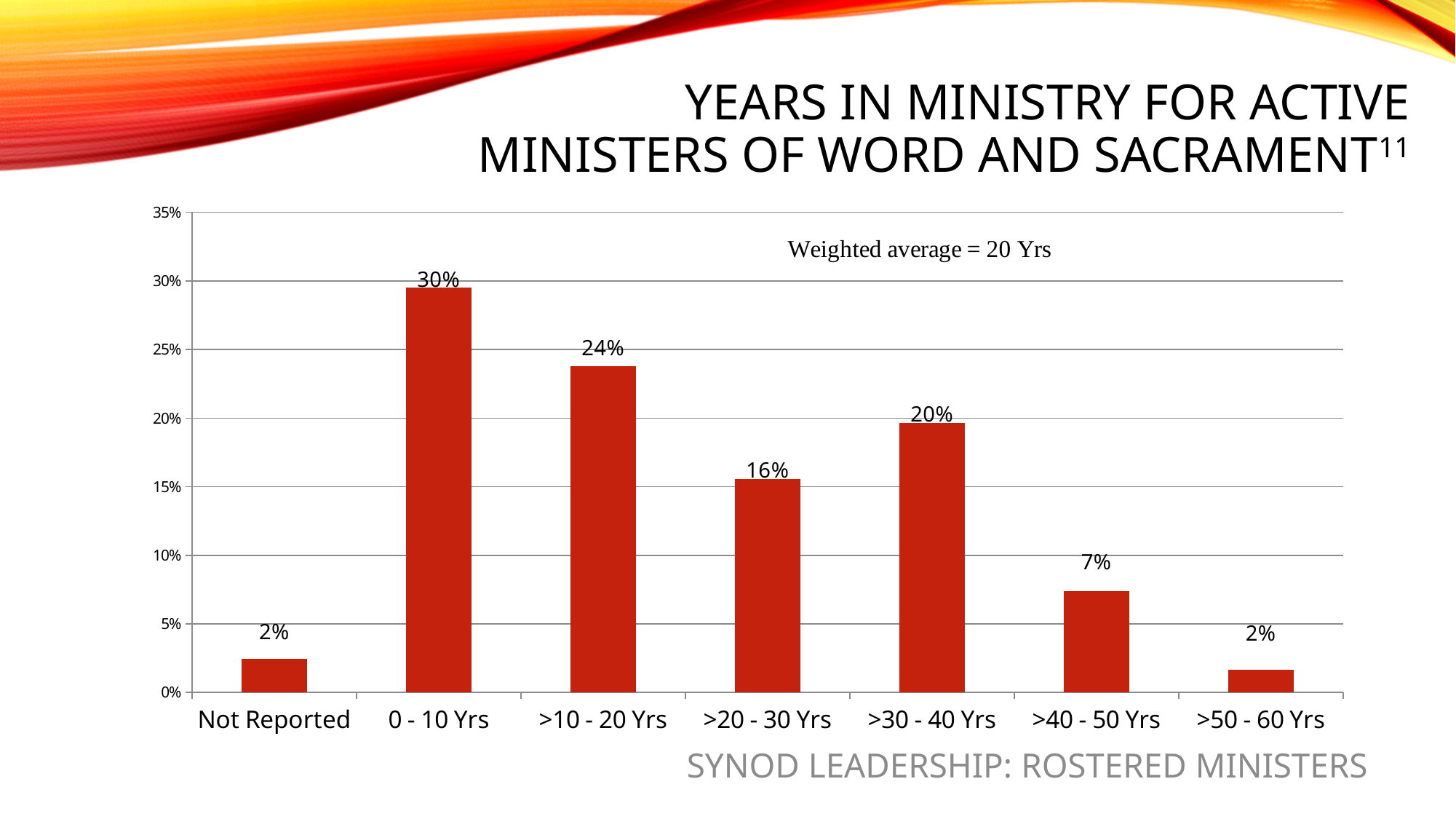
From 0 - 10 Yrs to >50 - 60 Yrs, do the values generally rise or fall? Fall How many categories are shown on the x axis? 7 What is the value for the >30 - 40 Yrs category? 20% What percentage of active ministers have 0 - 10 years in ministry? 30% Which is larger, the value for >20 - 30 Yrs or the value for >30 - 40 Yrs? >30 - 40 Yrs What weighted average is stated on the chart? 20 Yrs What is the difference between the >10 - 20 Yrs and >20 - 30 Yrs values? 8% What is the value for the Not Reported category? 2% Which category has the highest value? 0 - 10 Yrs What kind of chart is shown on the slide? Bar chart What percentage is shown for >40 - 50 Yrs? 7% Is the value for >10 - 20 Yrs greater or less than 20%? greater